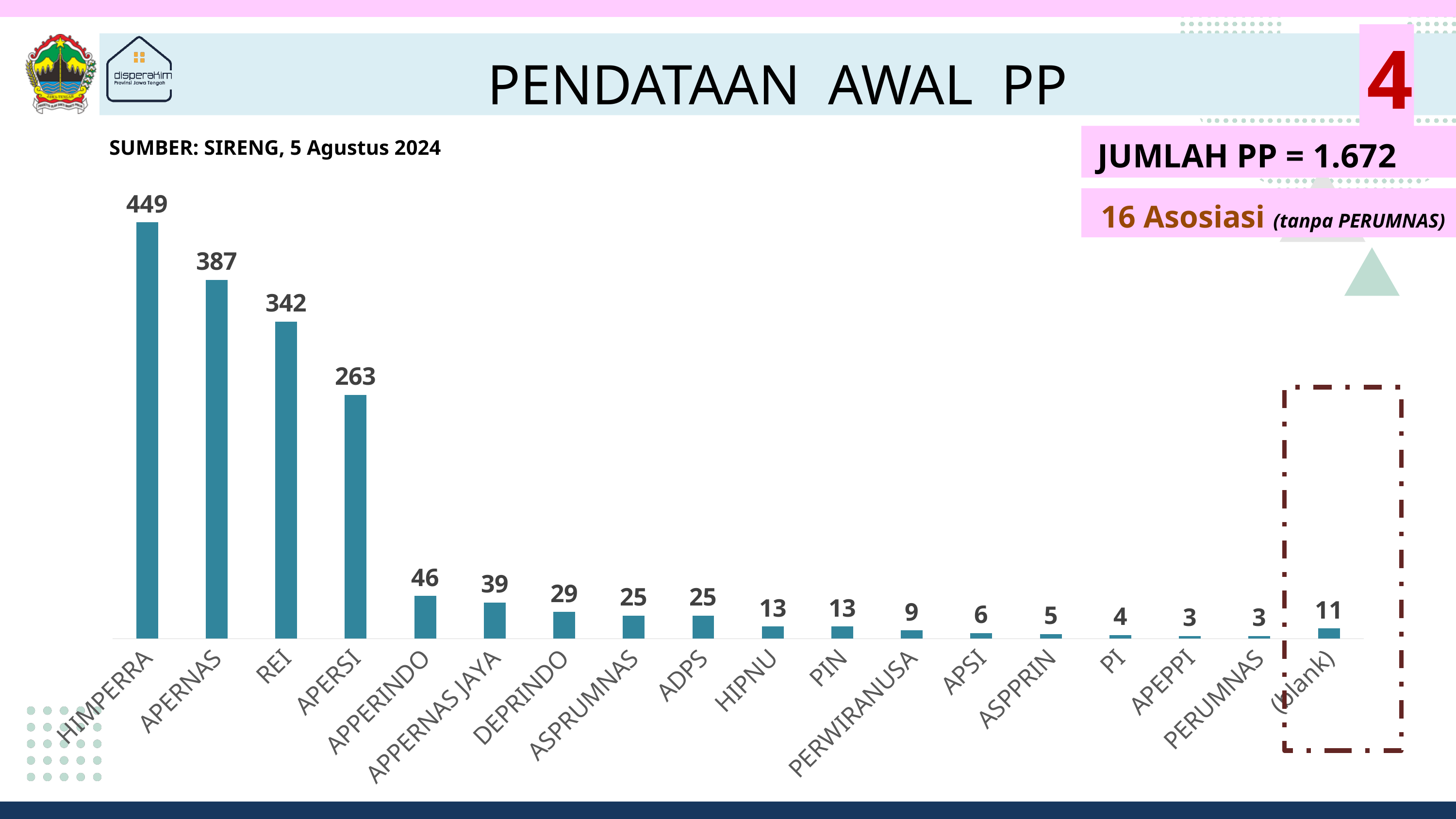
Which is larger, the value for APPERINDO or the value for APPERNAS JAYA? APPERINDO What is the value for DEPRINDO? 29 How many categories are shown on the x axis? 18 What is the difference between the values for HIMPERRA and APERSI? 186 What is the source stated above the chart? SIRENG, 5 Agustus 2024 What kind of chart is shown on the slide? Bar chart What is the difference between the values for APERNAS and REI? 45 Which category has the highest value? HIMPERRA What is the value for APERSI? 263 Which is larger, the value for PERWIRANUSA or the value for APSI? PERWIRANUSA What is the value for the (blank) category? 11 What is the value for HIMPERRA? 449